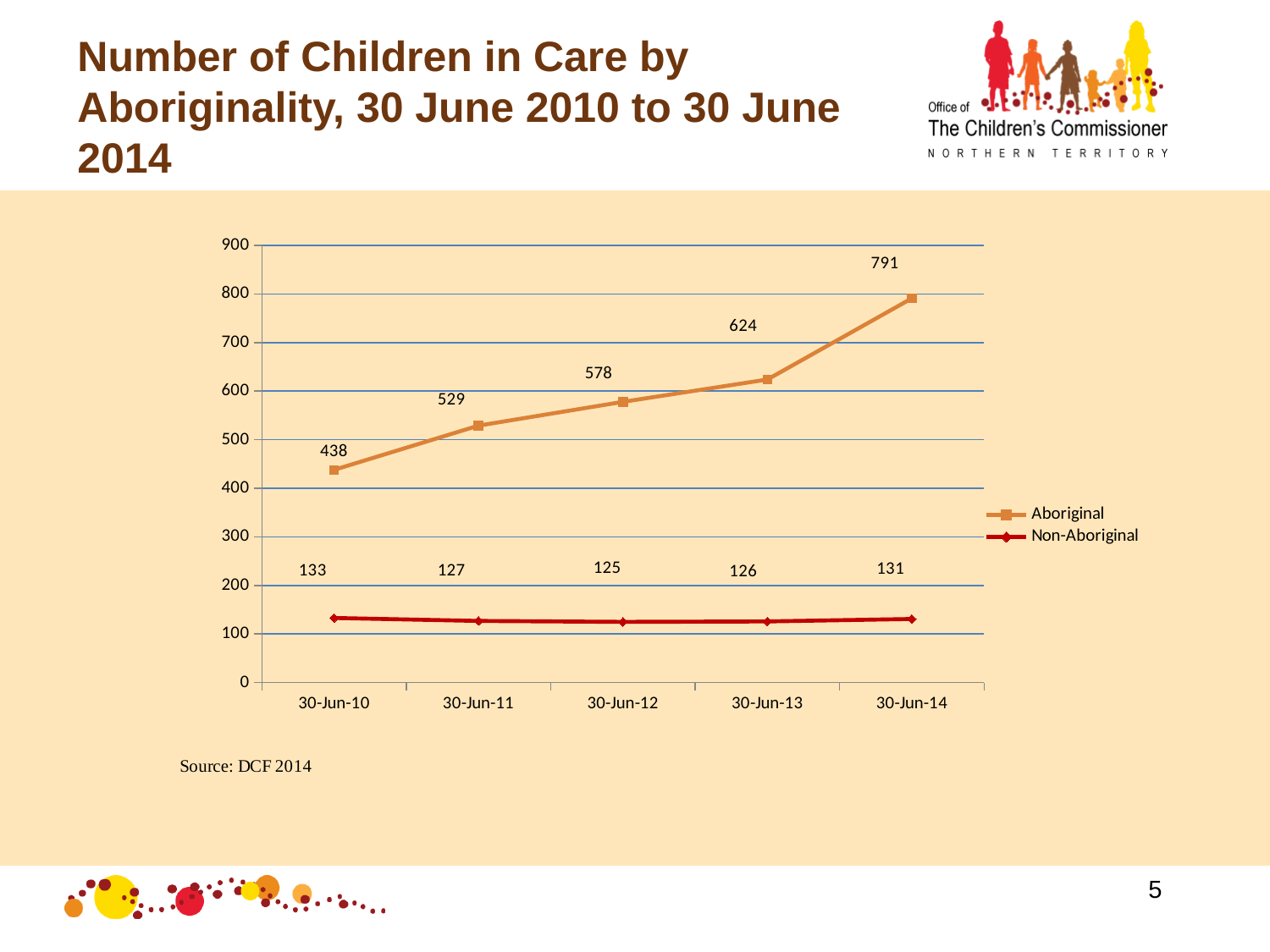
At which date is the Aboriginal series highest? 30-Jun-14 What is the value for Aboriginal children at 30-Jun-10? 438 Is the Aboriginal value at 30-Jun-13 greater or less than 600? greater How many dates are shown on the x axis? 5 What is the number of Non-Aboriginal children in care at 30-Jun-12? 125 What is the difference between the Aboriginal values at 30-Jun-14 and 30-Jun-13? 167 At which date is the Non-Aboriginal series lowest? 30-Jun-12 What is the number of Aboriginal children in care at 30-Jun-14? 791 Which is larger at 30-Jun-11: the Aboriginal value or the Non-Aboriginal value? Aboriginal What is the difference between the Aboriginal and Non-Aboriginal values at 30-Jun-10? 305 What kind of chart is shown on the slide? Line chart How many series does the legend list? 2